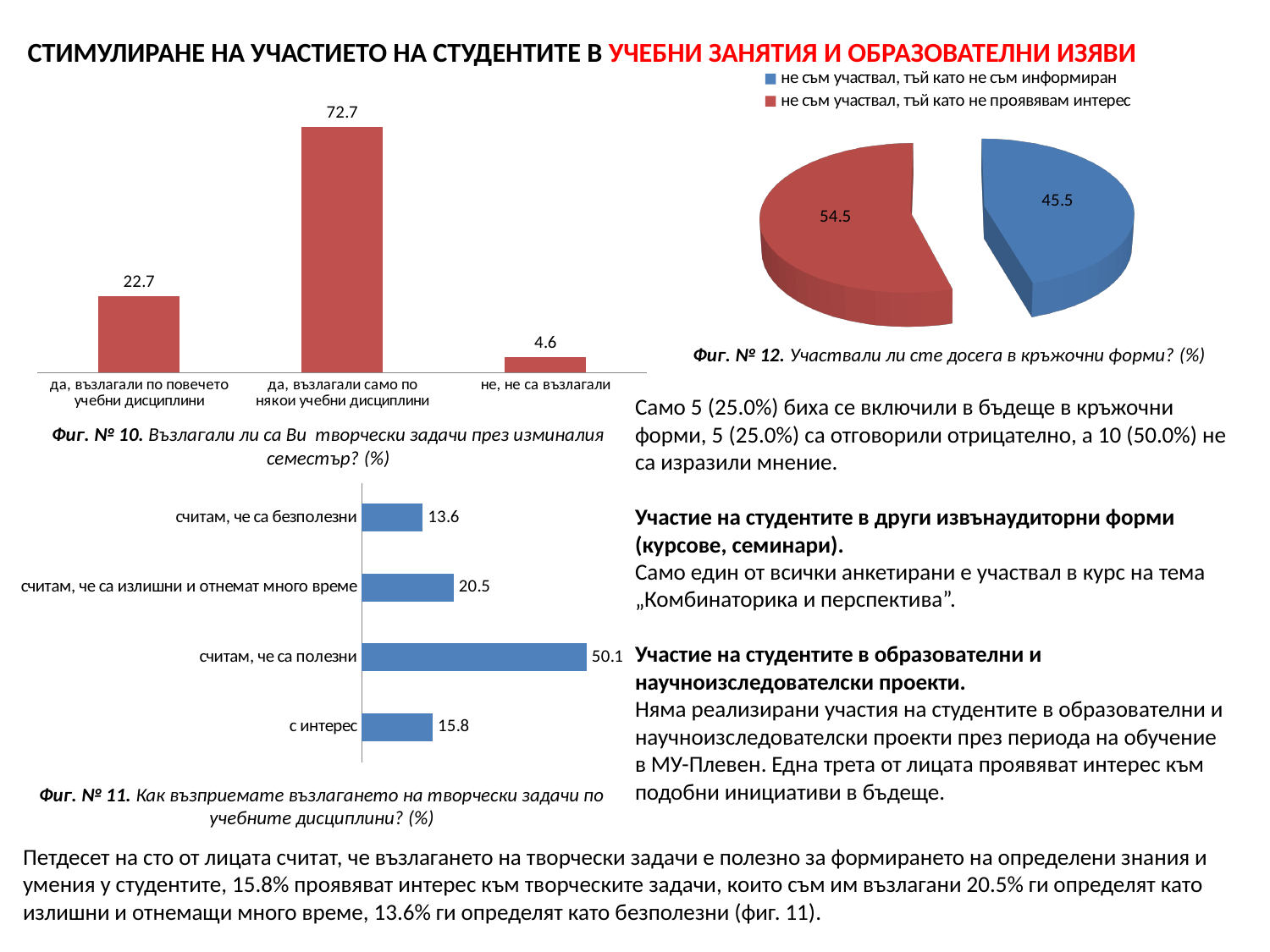
In the chart for Фиг. № 11, which is larger: the value for "считам, че са излишни и отнемат много време" or the value for "с интерес"? считам, че са излишни и отнемат много време What kind of chart is Фиг. № 12? pie chart In the chart for Фиг. № 10, which category has the lowest value? не, не са възлагали In the chart for Фиг. № 11, what is the difference between the values for "считам, че са излишни и отнемат много време" and "считам, че са безполезни"? 6.9 In the chart for Фиг. № 11, what is the value for "считам, че са полезни"? 50.1 In the chart for Фиг. № 10, what is the difference between the values for "да, възлагали само по някои учебни дисциплини" and "да, възлагали по повечето учебни дисциплини"? 50.0 What kind of chart is Фиг. № 11? bar chart How many entries does the legend of the pie chart for Фиг. № 12 list? 2 In the chart for Фиг. № 11, which category has the highest value? считам, че са полезни How many categories are shown in the chart for Фиг. № 10? 3 In the pie chart for Фиг. № 12, what is the value for "не съм участвал, тъй като не проявявам интерес"? 54.5 In the chart for Фиг. № 10, what is the value for "да, възлагали само по някои учебни дисциплини"? 72.7